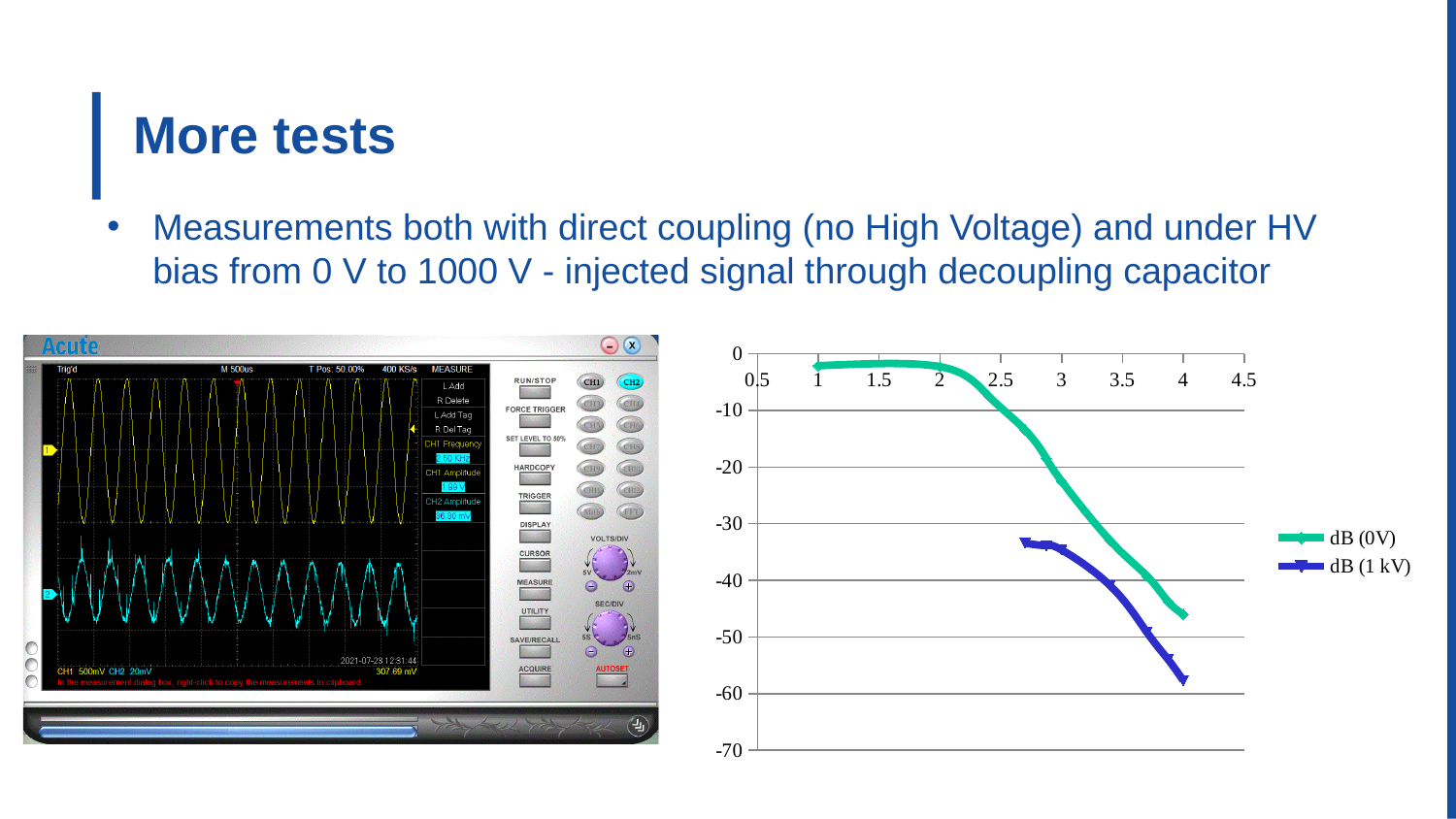
In the line chart, do the dB (0V) values rise or fall as the x axis increases? fall What kind of chart is shown on the right side of the slide? line chart In the line chart, is the dB (0V) value at x = 1 greater or less than -10? greater In the line chart, do the dB (1 kV) values rise or fall as the x axis increases? fall In the line chart, is the dB (0V) value at x = 4 greater or less than -40? less In the line chart, which series reaches the lowest value? dB (1 kV) In the line chart, which series is drawn in green? dB (0V) How many series does the legend of the line chart list? 2 In the line chart, which series has the higher value at x = 3.5, dB (0V) or dB (1 kV)? dB (0V) In the line chart, is the dB (1 kV) value at x = 4 greater or less than -50? less What are the two series named in the legend of the line chart? dB (0V) and dB (1 kV)